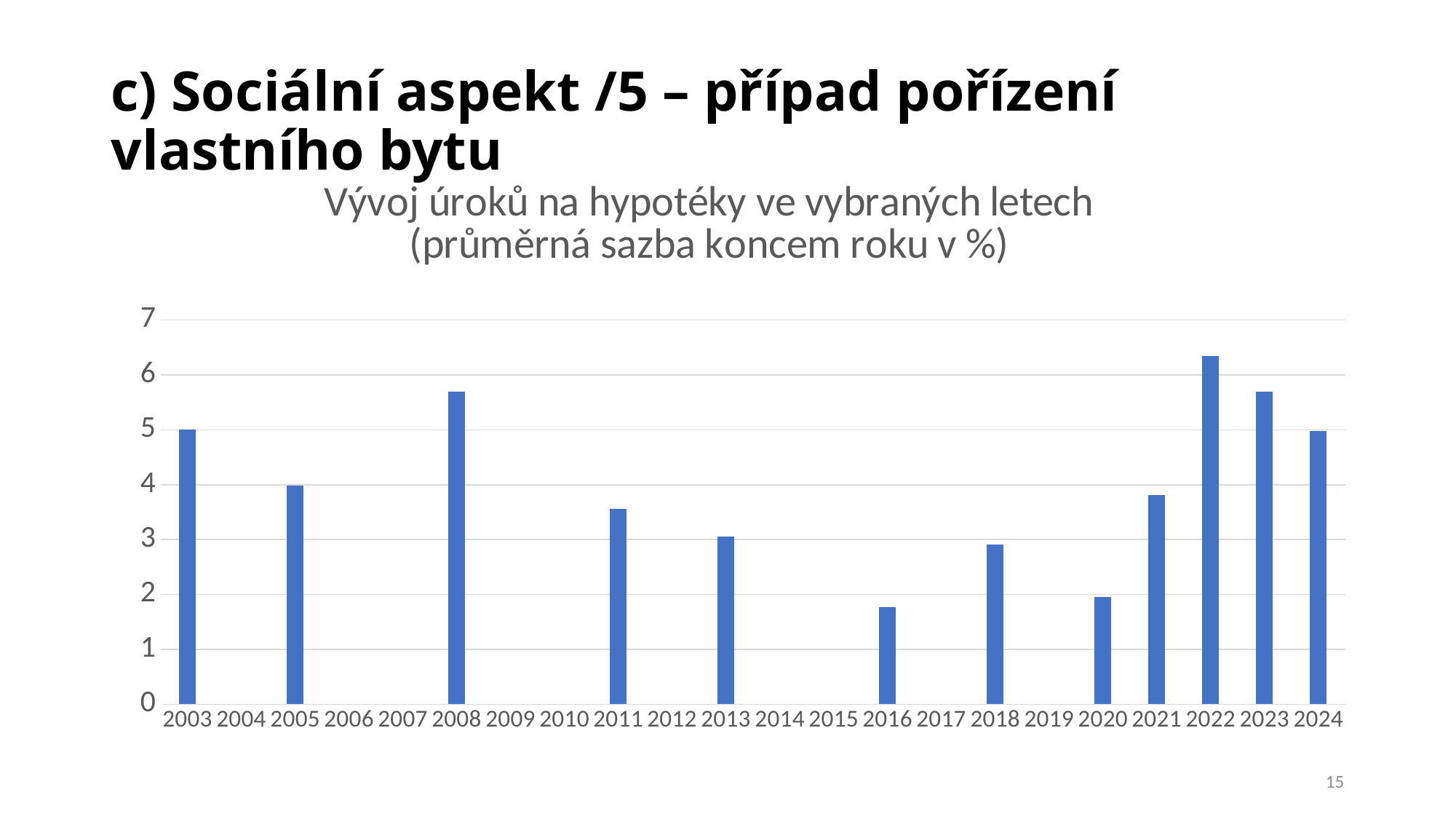
Is the value for 2008 greater or less than 5? greater What kind of chart is shown on the slide? bar chart Which year has the lowest bar? 2016 Which year has the highest bar? 2022 Which is larger, the value for 2022 or the value for 2023? 2022 What is the title of the chart? Vývoj úroků na hypotéky ve vybraných letech (průměrná sazba koncem roku v %) How many bars are plotted in the chart? 12 Is the value for 2016 greater or less than 2? less Do the values rise or fall from 2020 to 2022? rise Which is larger, the value for 2011 or the value for 2013? 2011 Is the value for 2022 greater or less than 6? greater